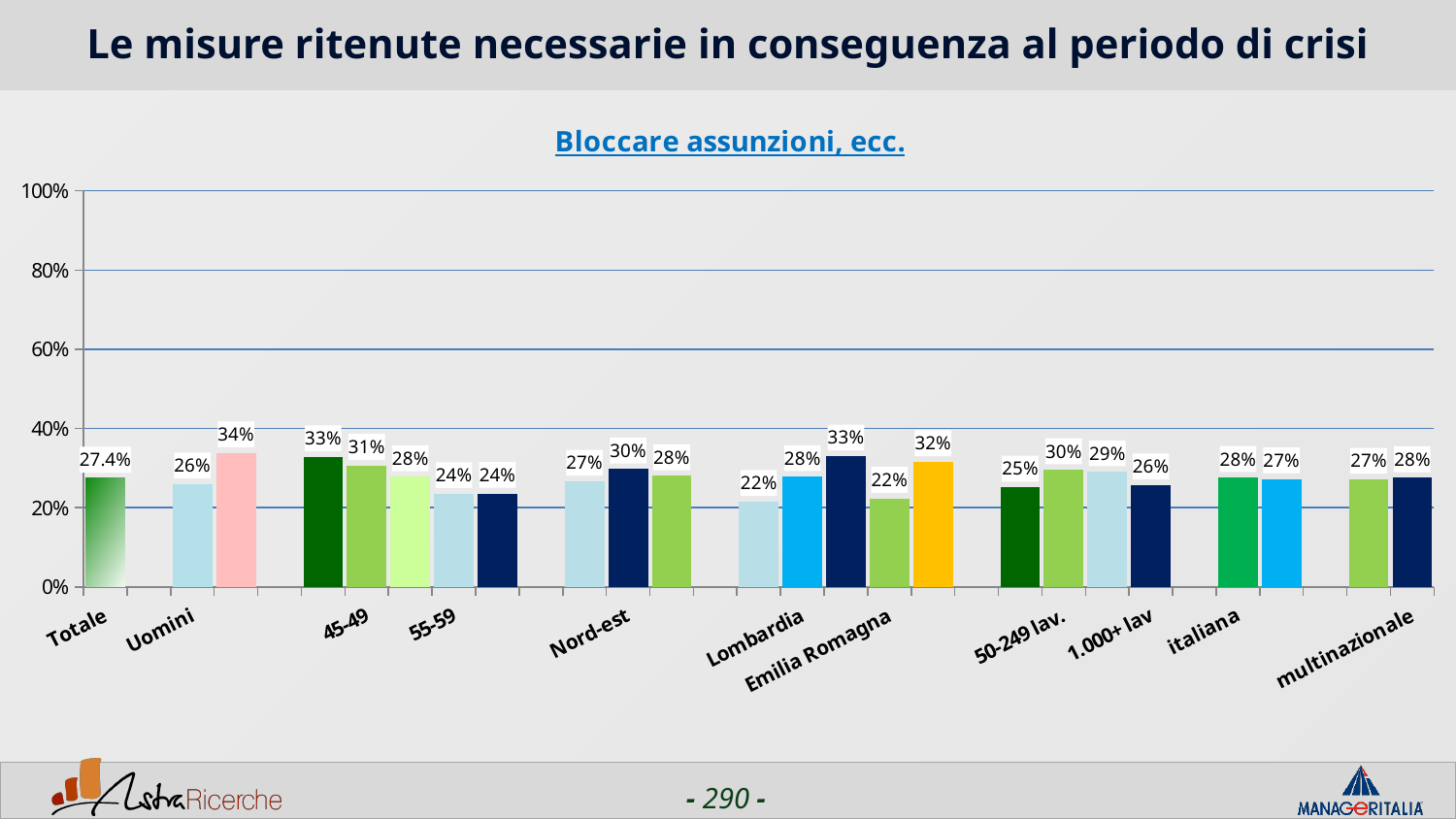
What is the value for multinazionale? 28% What is the value for 1.000+ lav? 26% Which is larger, the value for Totale or the value for Uomini? Totale What is the value for Uomini? 26% Is the value for Totale greater or less than 20%? greater Is the value for multinazionale greater or less than 40%? less What is the value for Emilia Romagna? 22% What is the difference between the value for Totale and the value for Uomini? 1.4 percentage points What is the value for Totale? 27.4% What is the highest value shown on the vertical axis? 100% What is the title of the chart? Bloccare assunzioni, ecc. What kind of chart is shown on the slide? bar chart